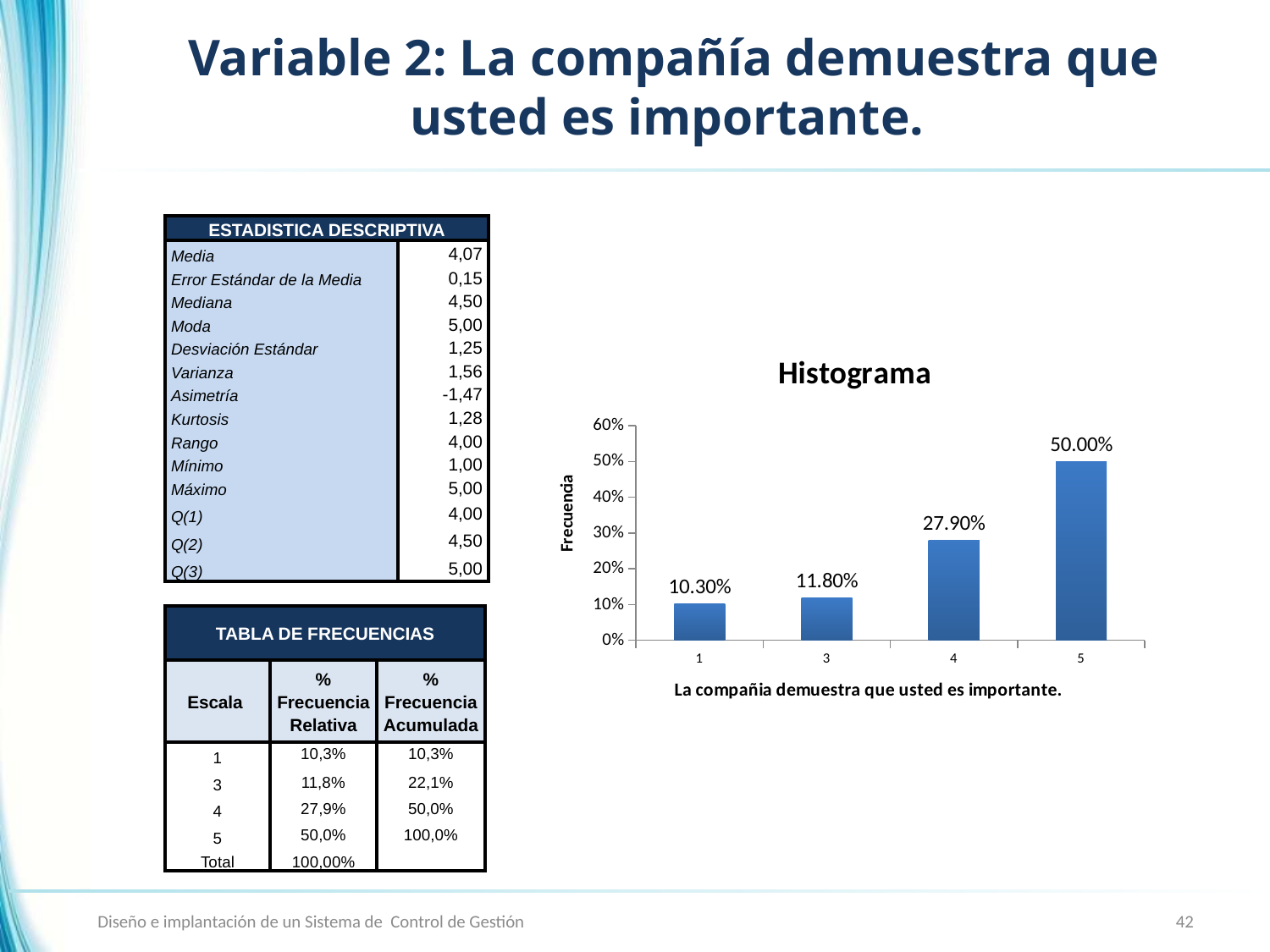
What is the value for category 3 in the Histograma chart? 11.80% Which is larger in the Histograma chart, the value for category 3 or the value for category 4? 4 How many bars are shown in the Histograma chart? 4 What is the difference between the values for category 5 and category 4 in the Histograma chart? 22.10% Which category has the highest value in the Histograma chart? 5 Do the values in the Histograma chart rise or fall from left to right along the x axis? rise What kind of chart is the Histograma chart? bar chart Is the value for category 4 in the Histograma chart greater or less than 20%? greater What is the y-axis label of the Histograma chart? Frecuencia What is the value for category 1 in the Histograma chart? 10.30% What is the value for category 4 in the Histograma chart? 27.90% Which category has the lowest value in the Histograma chart? 1